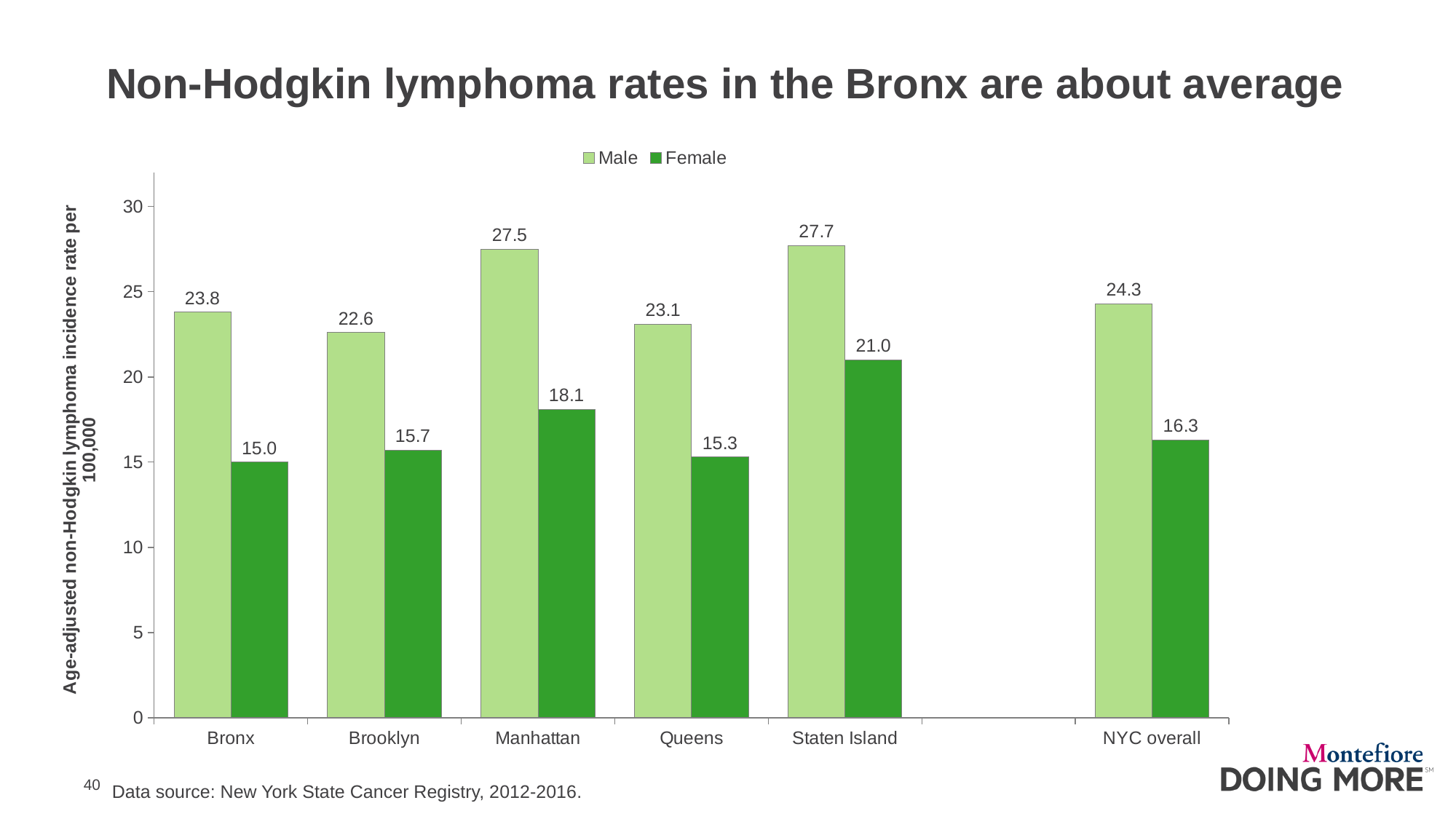
What is the Female rate for NYC overall? 16.3 What is the difference between the Male and Female rates for Manhattan? 9.4 What kind of chart is shown on the slide? Bar chart How many categories are shown on the x axis? 6 What is the Male non-Hodgkin lymphoma incidence rate for the Bronx? 23.8 Which category has the lowest Female rate? Bronx Is the Female rate for Staten Island greater or less than 20? greater Which is larger, the Male rate for Brooklyn or the Male rate for Queens? Queens Which category has the highest Male rate? Staten Island What is the title of the slide? Non-Hodgkin lymphoma rates in the Bronx are about average How many series does the legend list? 2 What is the Female non-Hodgkin lymphoma incidence rate for Staten Island? 21.0